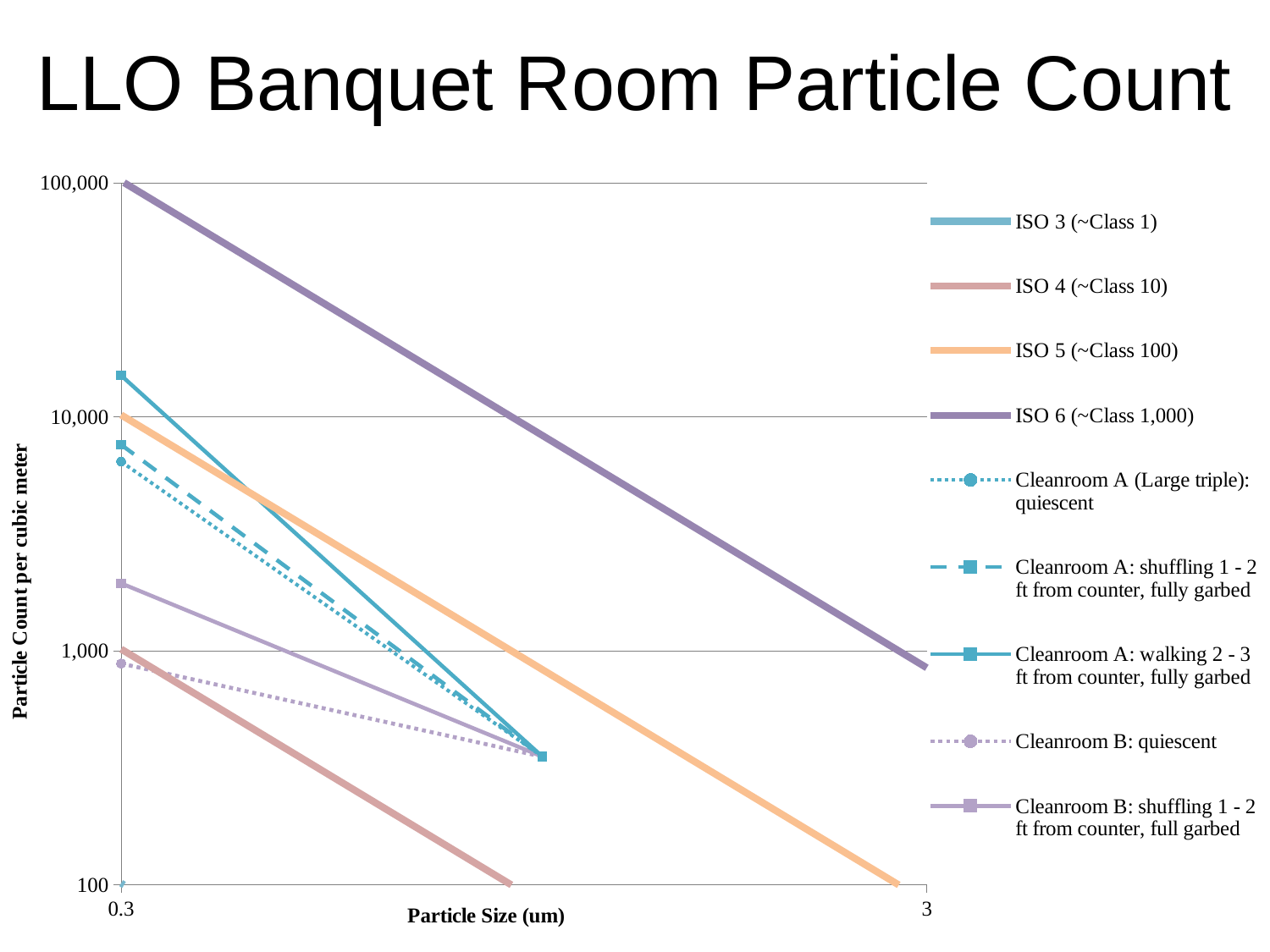
Is the value for Cleanroom A: walking 2 - 3 ft from counter, fully garbed at 0.3 um greater or less than 10,000? greater Which series has the highest particle count at a particle size of 0.3 um? ISO 6 (~Class 1,000) Is the value for Cleanroom B: shuffling 1 - 2 ft from counter, full garbed at 0.3 um greater or less than 1,000? greater What is the label of the x axis? Particle Size (um) Is the value for Cleanroom B: quiescent at 0.3 um greater or less than 1,000? less What is the title of the chart? LLO Banquet Room Particle Count Do the particle counts rise or fall as particle size increases along the x axis? fall At 0.3 um, which is larger: Cleanroom A: walking 2 - 3 ft from counter, fully garbed or Cleanroom A (Large triple): quiescent? Cleanroom A: walking 2 - 3 ft from counter, fully garbed What kind of chart is shown on the slide? line chart How many series does the legend list? 9